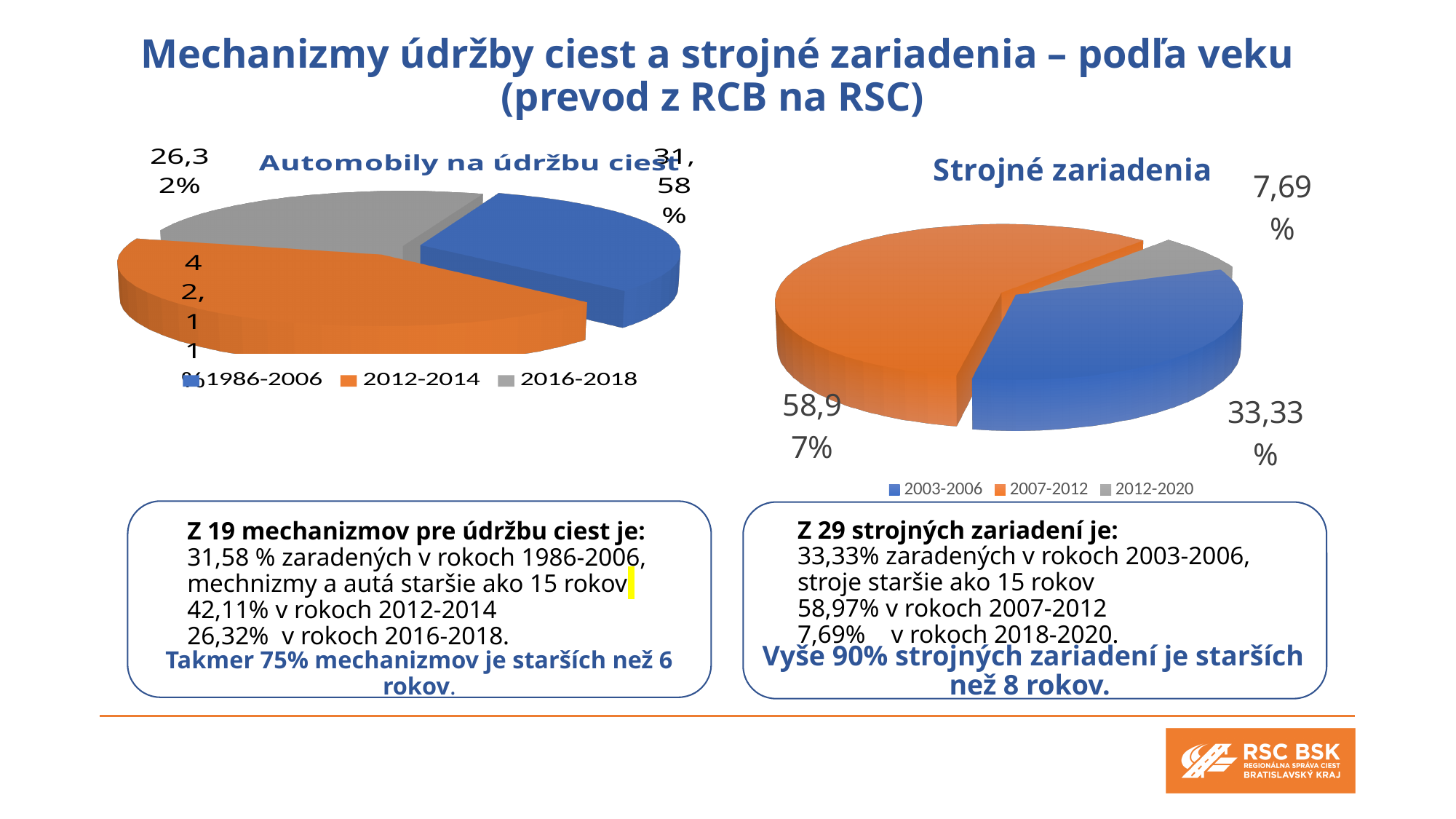
In the "Automobily na údržbu ciest" chart, what share is shown for 1986-2006? 31,58% In the "Strojné zariadenia" chart, what share is shown for 2007-2012? 58,97% In the "Automobily na údržbu ciest" chart, which category has the largest slice? 2012-2014 What type of chart is "Automobily na údržbu ciest"? pie chart In the "Strojné zariadenia" chart, which is larger: the slice for 2003-2006 or the slice for 2012-2020? 2003-2006 In the "Strojné zariadenia" chart, what is the difference between the shares for 2007-2012 and 2003-2006? 25,64% In the "Strojné zariadenia" chart, what share is shown for 2012-2020? 7,69% In the "Strojné zariadenia" chart, which category has the largest slice? 2007-2012 In the "Automobily na údržbu ciest" chart, what share is shown for 2012-2014? 42,11% In the "Automobily na údržbu ciest" chart, which category has the smallest slice? 2016-2018 How many categories does the legend of the "Automobily na údržbu ciest" chart list? 3 In the "Strojné zariadenia" chart, which colour represents 2007-2012? orange